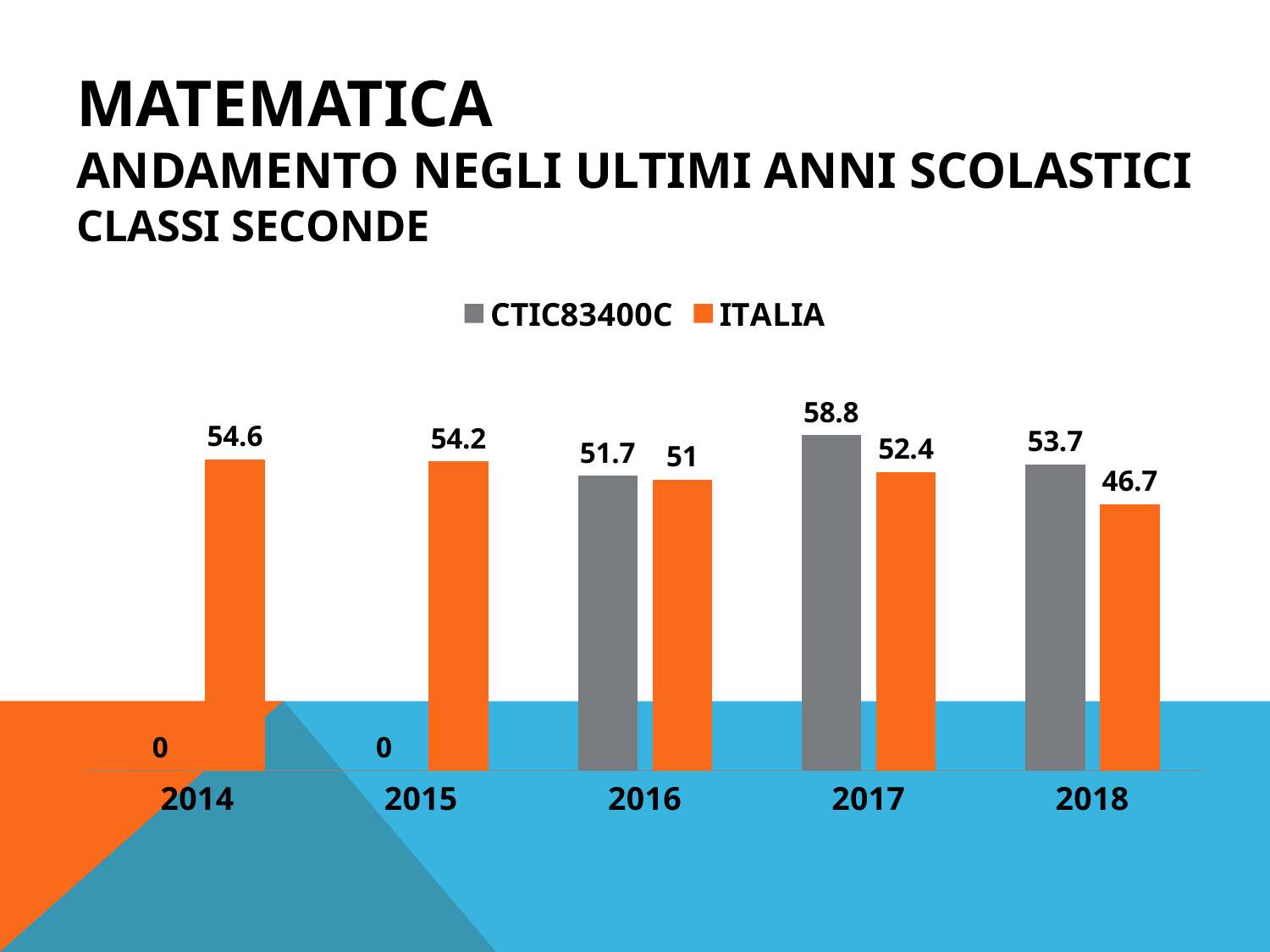
What kind of chart is shown on the slide? Bar chart Which is larger in 2018, the CTIC83400C value or the ITALIA value? CTIC83400C What is the ITALIA value for 2018? 46.7 In which year is the ITALIA value lowest? 2018 Does the ITALIA value rise or fall from 2014 to 2018? Fall In which year is the CTIC83400C value highest? 2017 What is the difference between the CTIC83400C and ITALIA values in 2017? 6.4 What is the CTIC83400C value for 2016? 51.7 What is the CTIC83400C value for 2017? 58.8 What is the ITALIA value for 2014? 54.6 How many series does the legend list? 2 How many years are shown on the x axis? 5